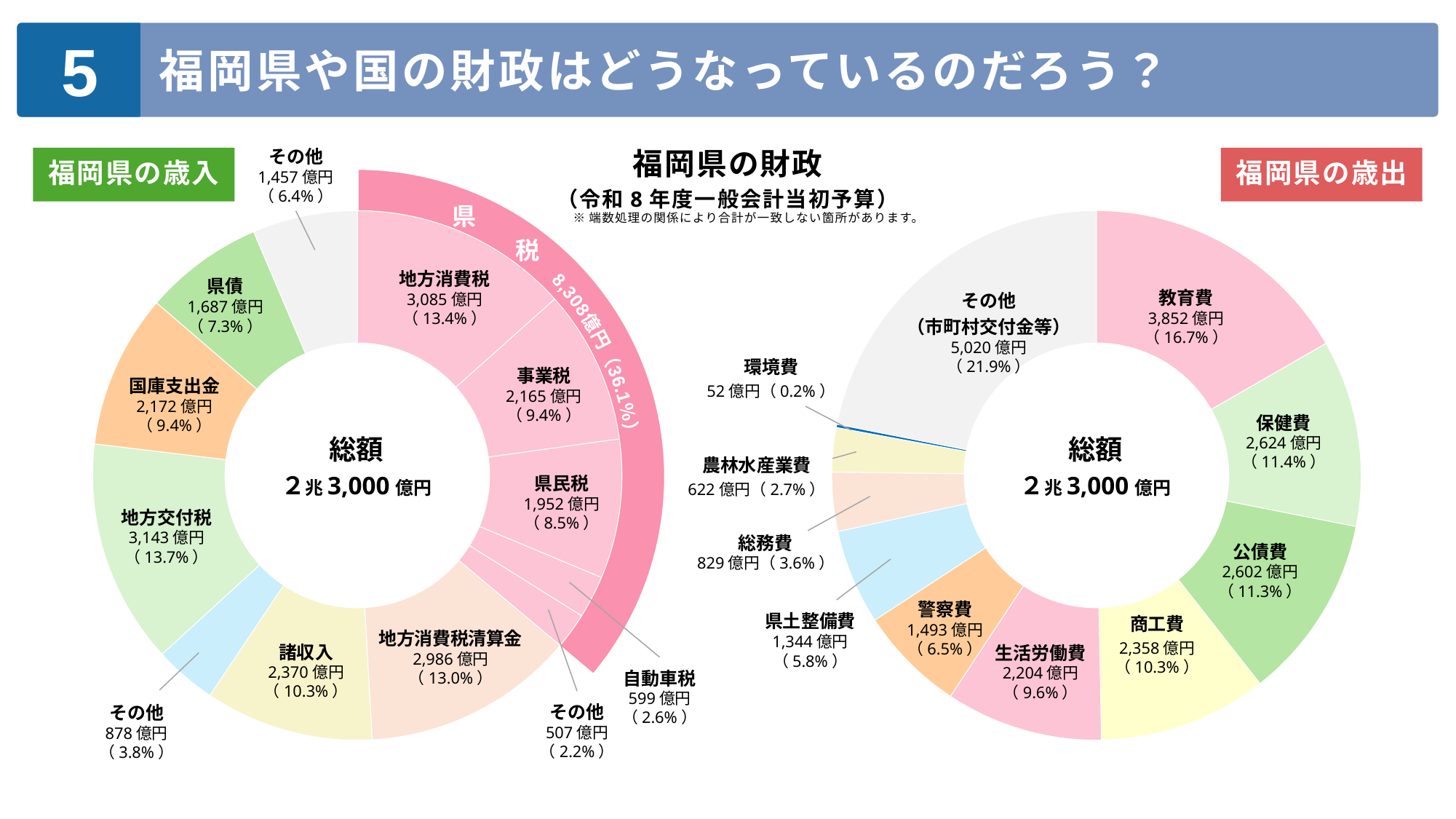
On the 福岡県の歳入 chart, what share of the total is 県税? 36.1% On the 福岡県の歳出 chart, which category has the largest value? その他（市町村交付金等） How many categories are shown on the 福岡県の歳出 chart? 11 On the 福岡県の歳入 chart, what is the value for 県債? 1,687 億円 On the 福岡県の歳出 chart, which is larger, 保健費 or 商工費? 保健費 On the 福岡県の歳出 chart, which category has the smallest value? 環境費 On the 福岡県の歳入 chart, what share of the total is 地方交付税? 13.7% What kind of chart is used for 福岡県の歳出? Donut (pie) chart On the 福岡県の歳出 chart, what is the value for 教育費? 3,852 億円 On the 福岡県の歳入 chart, what is the difference between 地方消費税 and 事業税? 920 億円 On the 福岡県の歳出 chart, what is the difference between 警察費 and 県土整備費? 149 億円 What is the total amount shown in the centre of the 福岡県の歳入 chart? 2兆3,000億円